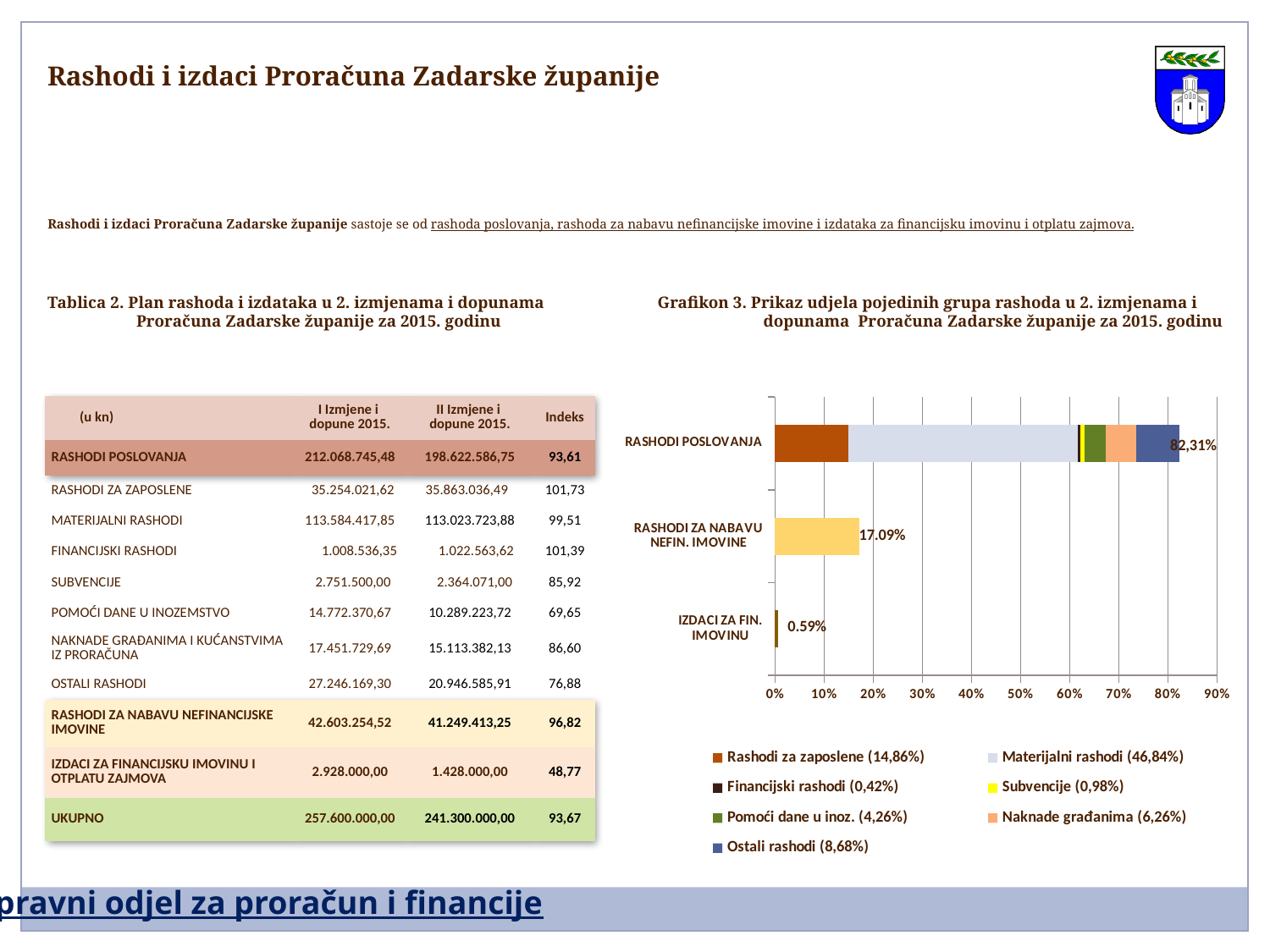
In Grafikon 3, what is the data label shown for IZDACI ZA FIN. IMOVINU? 0.59% In Grafikon 3, what is the data label shown for RASHODI POSLOVANJA? 82,31% In Grafikon 3, which category has the lowest total share? IZDACI ZA FIN. IMOVINU What kind of chart is Grafikon 3? Stacked horizontal bar chart In Grafikon 3, what is the data label shown for RASHODI ZA NABAVU NEFIN. IMOVINE? 17.09% How many entries does the legend of Grafikon 3 list? 7 In Grafikon 3, is the value for RASHODI POSLOVANJA greater or less than 80%? greater In Grafikon 3, which is larger: RASHODI POSLOVANJA or RASHODI ZA NABAVU NEFIN. IMOVINE? RASHODI POSLOVANJA How many categories are plotted on the vertical axis of Grafikon 3? 3 In the legend of Grafikon 3, what percentage is given for Materijalni rashodi? 46,84% In Grafikon 3, is the value for RASHODI ZA NABAVU NEFIN. IMOVINE greater or less than 20%? less In Grafikon 3, which category has the highest total share? RASHODI POSLOVANJA